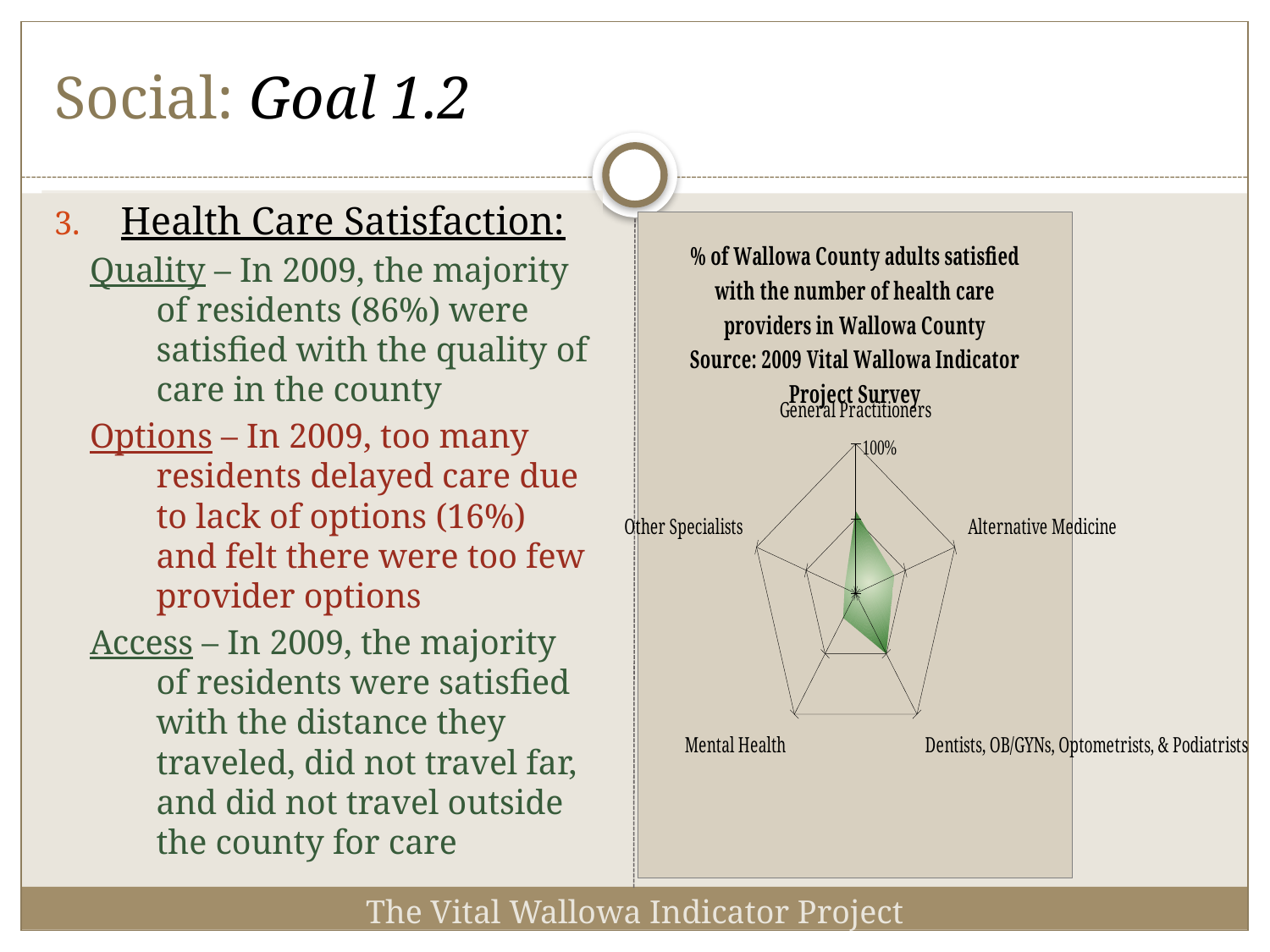
Is the value for General Practitioners greater or less than 100%? less Which is larger in the radar chart: the value for Dentists, OB/GYNs, Optometrists, & Podiatrists or the value for Mental Health? Dentists, OB/GYNs, Optometrists, & Podiatrists What is the only percentage tick label printed on the radar chart's axis? 100% Which is larger in the radar chart: the value for Alternative Medicine or the value for Other Specialists? Alternative Medicine How many categories (axes) does the radar chart have? 5 Which is larger in the radar chart: the value for General Practitioners or the value for Mental Health? General Practitioners Which category has the highest value in the radar chart? General Practitioners What source is cited in the chart title? 2009 Vital Wallowa Indicator Project Survey What kind of chart is shown on the slide? Radar chart